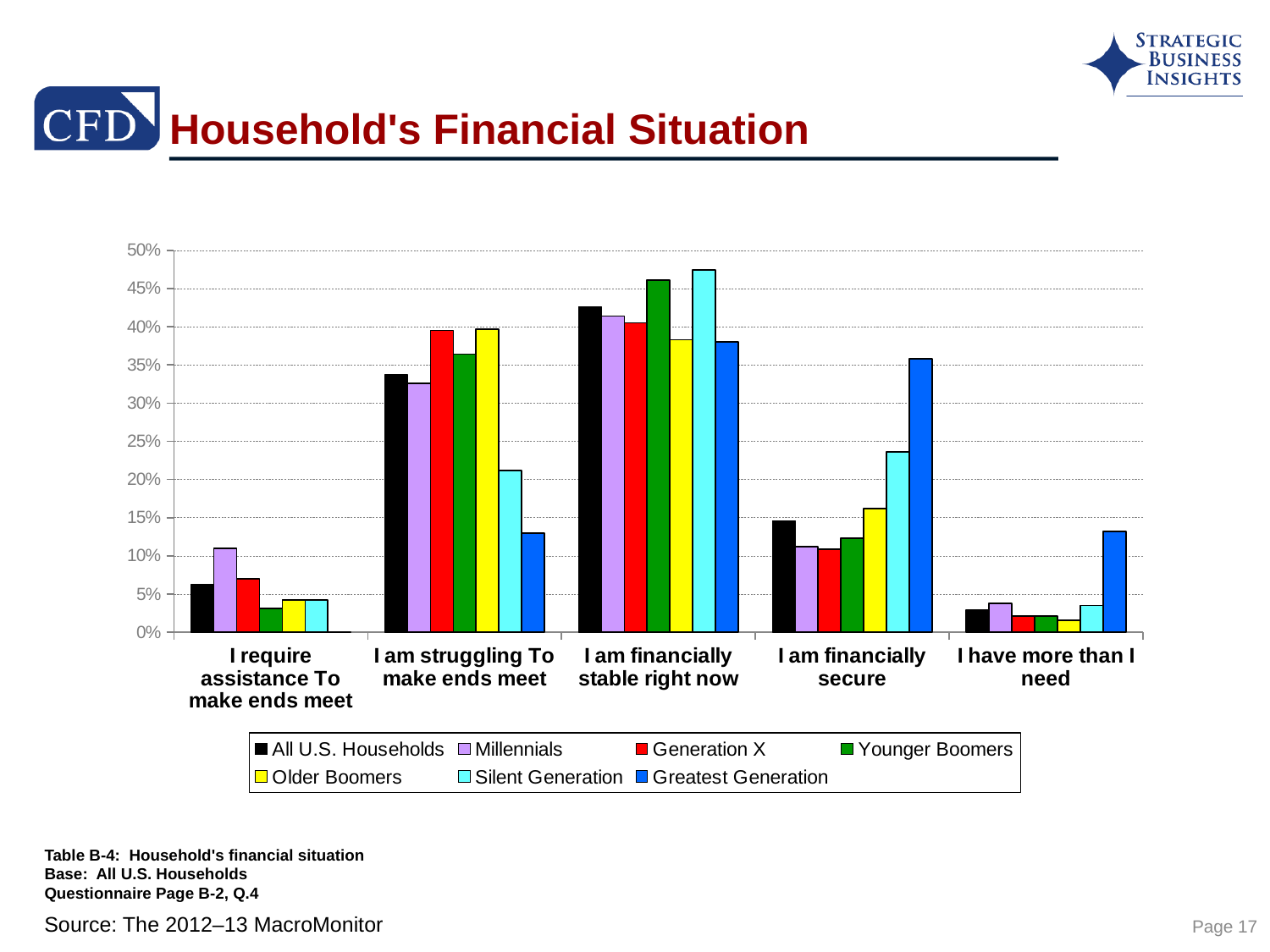
For "I am financially secure", which is larger: Older Boomers or Silent Generation? Silent Generation Is the Greatest Generation value for "I am financially secure" greater or less than 30%? greater What type of chart is shown on the slide? Bar chart What is the title of the chart? Household's Financial Situation Which series has the lowest value for "I am struggling To make ends meet"? Greatest Generation For "I am struggling To make ends meet", which is larger: Millennials or Generation X? Generation X How many financial-situation categories are shown along the x axis? 5 Which series has the highest value for "I am financially secure"? Greatest Generation Is the Silent Generation value for "I am struggling To make ends meet" greater or less than 25%? less How many series does the legend list? 7 Which series has the highest value for "I require assistance To make ends meet"? Millennials Is the All U.S. Households value for "I am financially stable right now" greater or less than 40%? greater